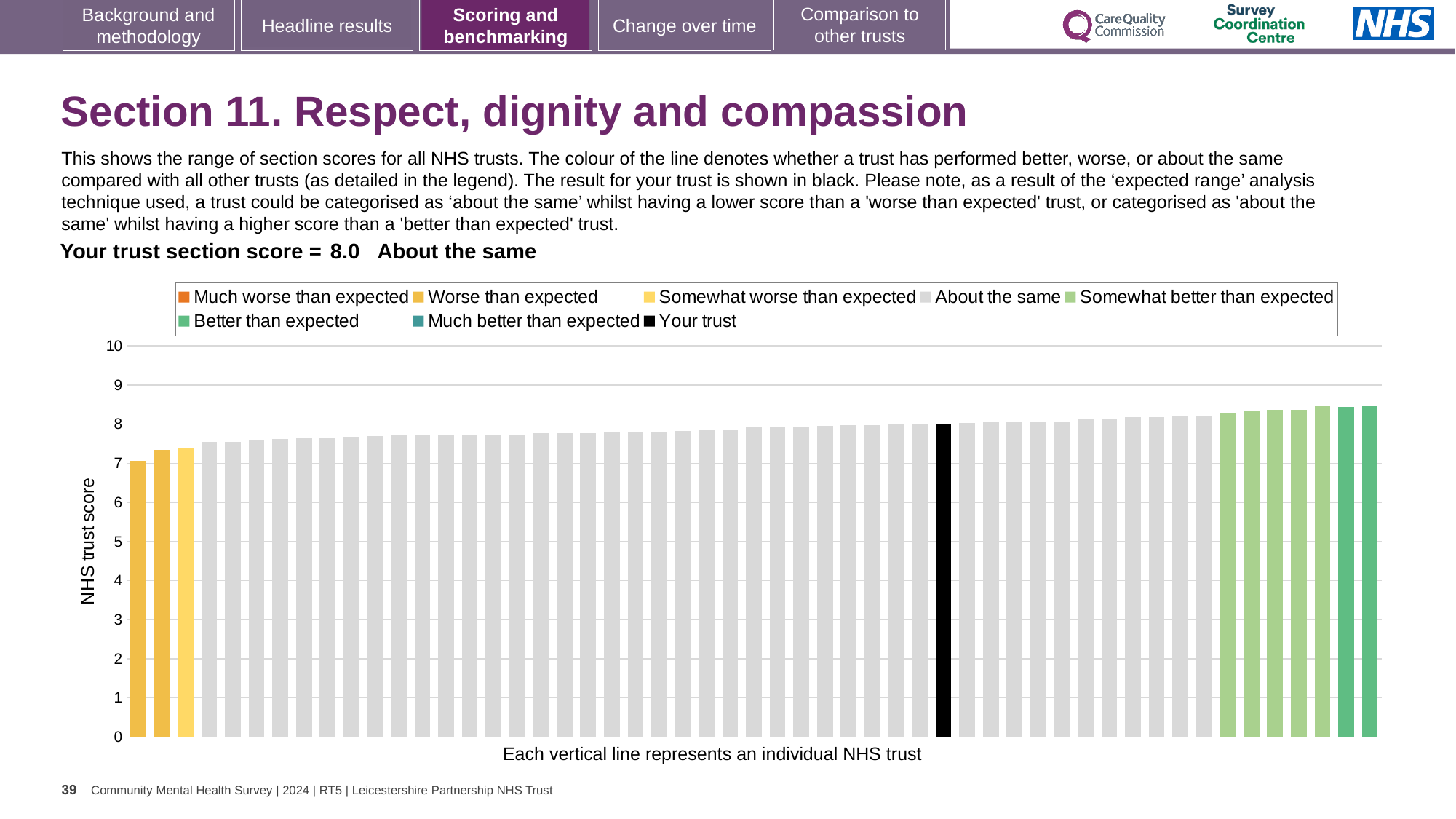
Is the highest trust score in the chart greater or less than 9? less Do the trust scores rise or fall moving from left to right along the x axis? rise What is the section score for your trust shown on the slide? 8.0 Is the lowest trust score in the chart greater or less than 6? greater What is the label on the vertical axis of the chart? NHS trust score Is the lowest trust score in the chart greater or less than 8? less How many entries does the chart legend list? 8 What kind of chart is shown on the slide? bar chart What colour is the bar representing your trust in the chart? black How is your trust's section score categorised compared with other trusts? About the same